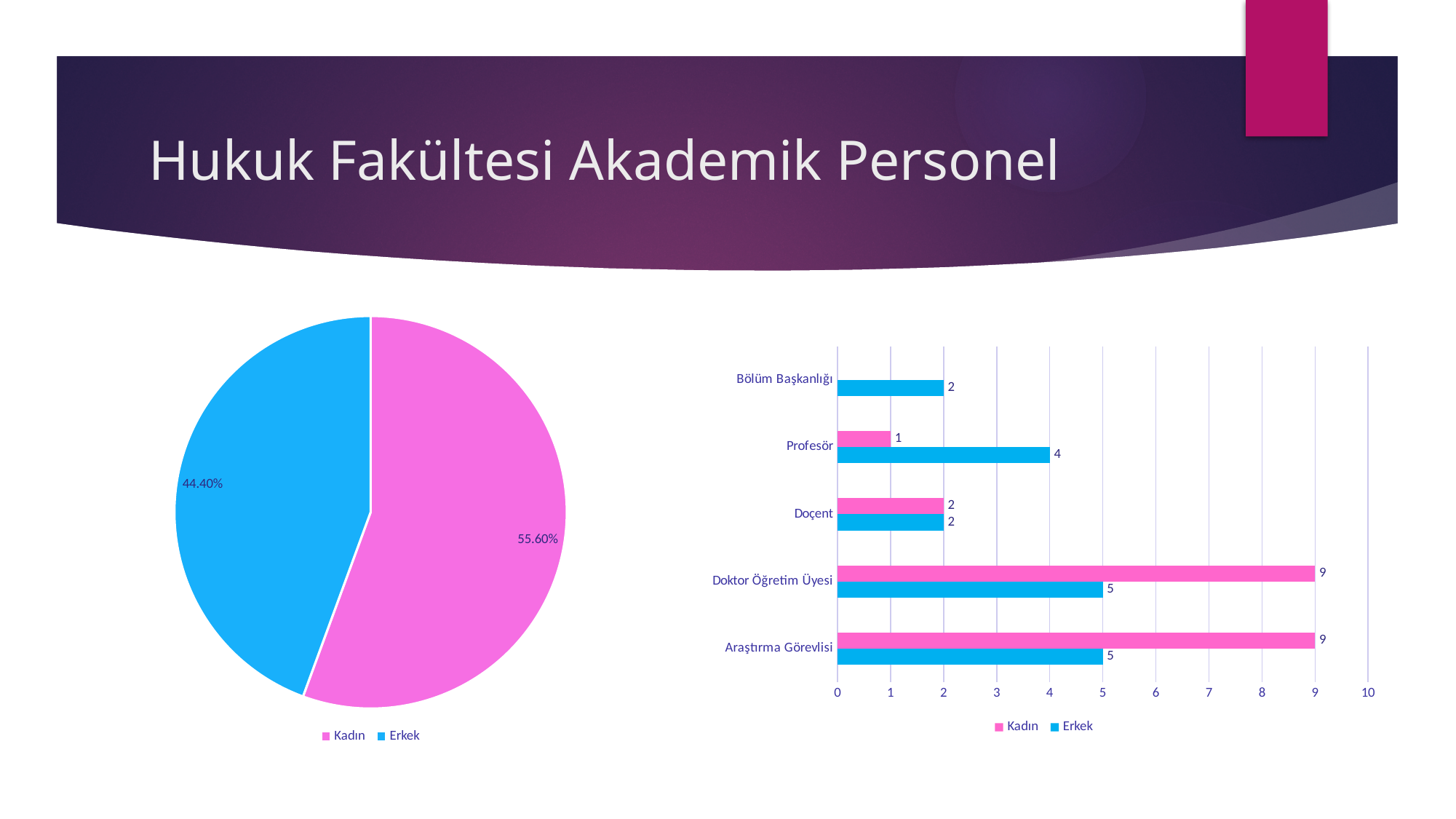
In the bar chart on the right, which is larger for Profesör, the Kadın value or the Erkek value? Erkek In the pie chart on the left, what share does Kadın have? 55.60% How many categories are shown on the bar chart on the right? 5 In the bar chart on the right, what is the difference between the Kadın and Erkek values for Araştırma Görevlisi? 4 In the bar chart on the right, what is the Erkek value for Bölüm Başkanlığı? 2 How many series does the legend of the bar chart on the right list? 2 In the pie chart on the left, which slice is larger, Kadın or Erkek? Kadın In the bar chart on the right, what is the Erkek value for Profesör? 4 In the pie chart on the left, what share does Erkek have? 44.40% What kind of chart is the chart on the left of the slide? Pie chart In the bar chart on the right, what is the Kadın value for Doktor Öğretim Üyesi? 9 What kind of chart is the chart on the right of the slide? Bar chart